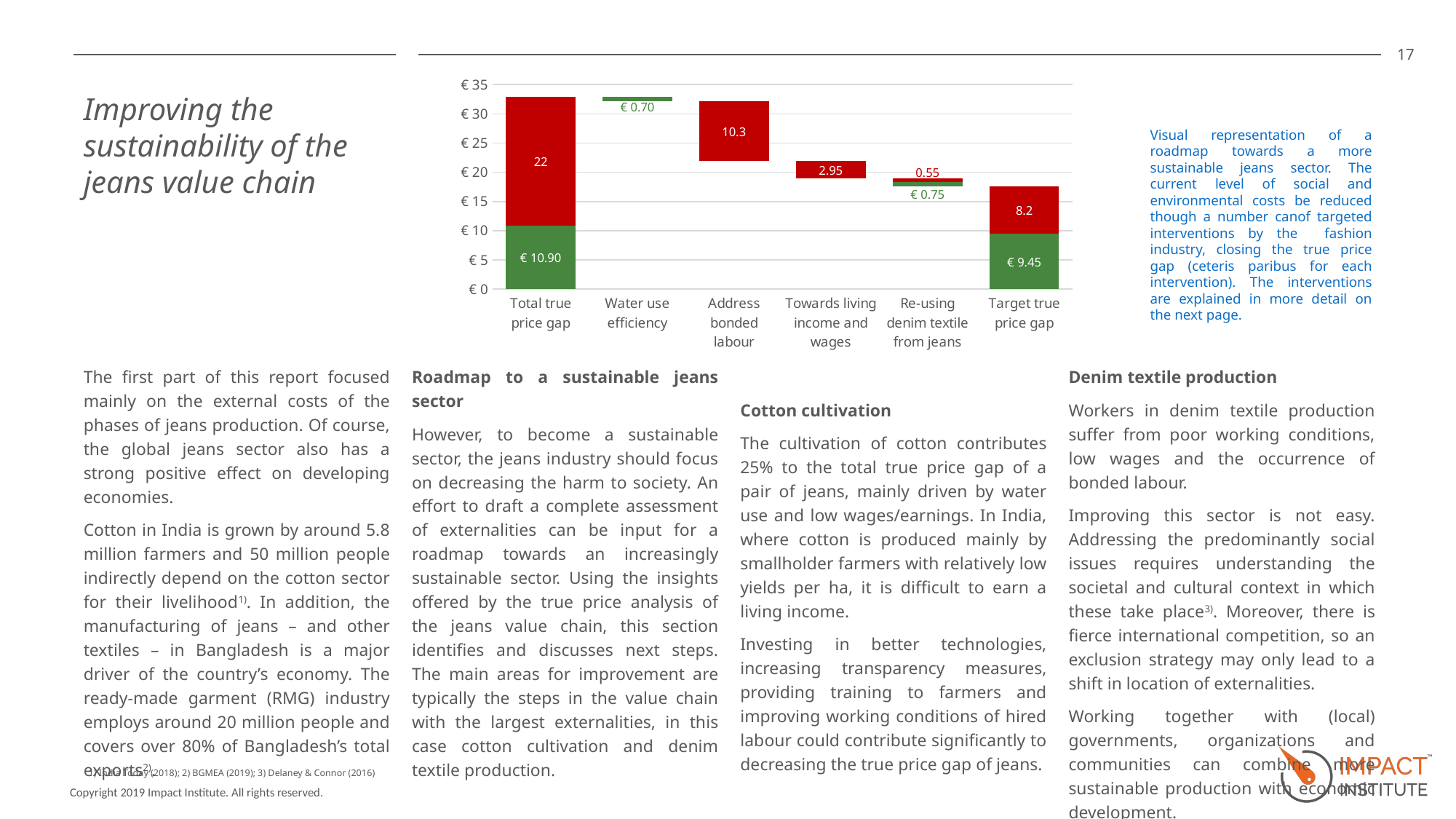
What value is shown for 'Towards living income and wages'? 2.95 What value is shown for 'Water use efficiency'? € 0.70 What is the difference between the red segment of 'Total true price gap' (22) and the red segment of 'Target true price gap' (8.2)? 13.8 Which is larger: the value for 'Address bonded labour' or the value for 'Towards living income and wages'? Address bonded labour What is the combined total of the two labelled segments of the 'Total true price gap' bar? 32.90 What is the value of the green segment for 'Target true price gap'? € 9.45 How many categories are shown on the x axis of the chart? 6 What value is shown for 'Address bonded labour'? 10.3 What is the value of the green segment for 'Total true price gap'? € 10.90 What is the value of the red segment for 'Total true price gap'? 22 What kind of chart is shown on the slide? Bar chart Which of the intervention steps between the total and target true price gap has the largest labelled value? Address bonded labour